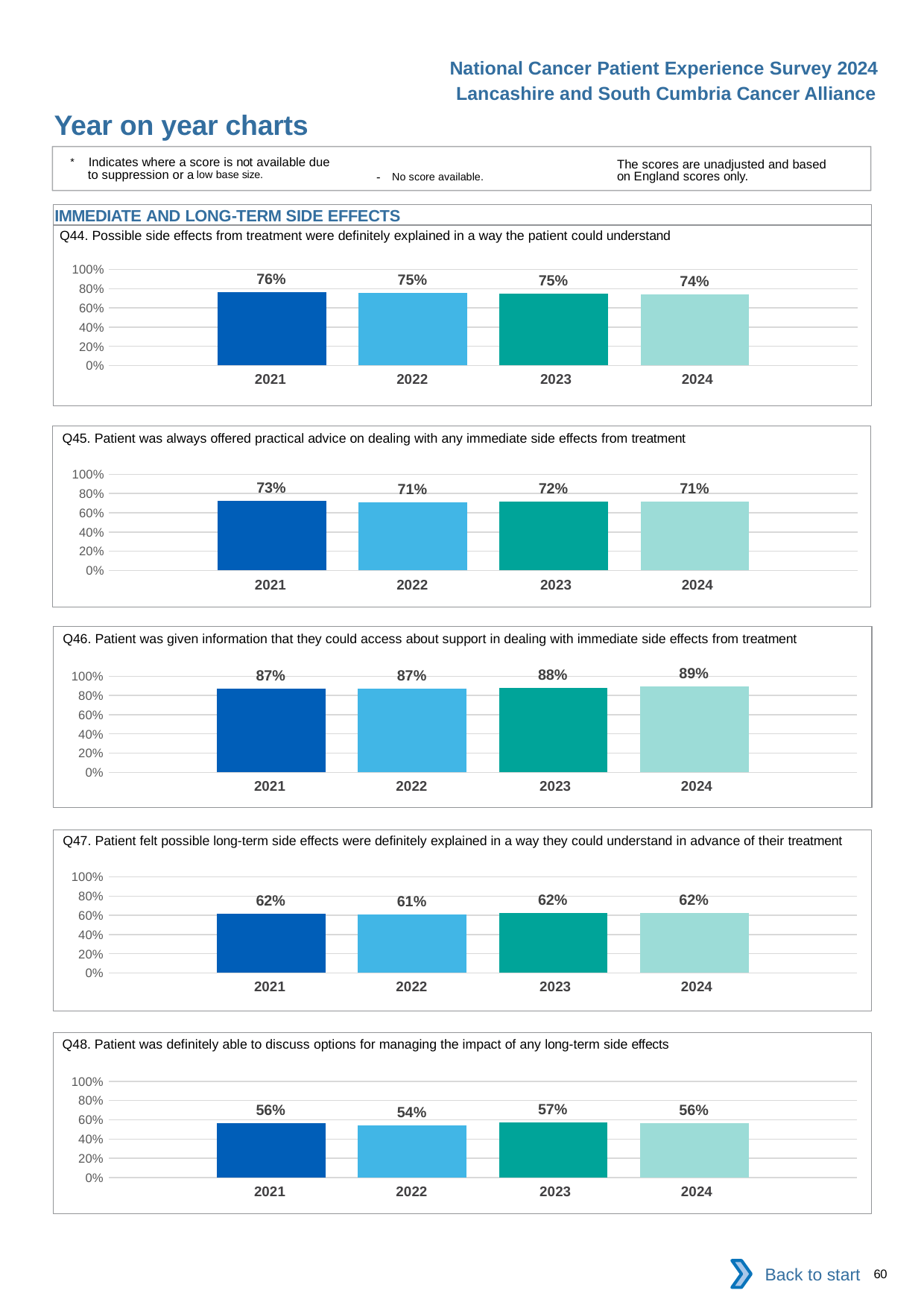
In the Q46 chart, do the values generally rise or fall from 2021 to 2024? rise In the Q48 chart, which is larger, the value for 2021 or the value for 2022? 2021 In the Q44 chart, which year has the lowest value? 2024 What kind of chart is the Q44 chart? bar chart In the Q45 chart, what is the difference between the 2021 and 2022 values? 2% In the Q47 chart, what is the value for 2022? 61% In the Q48 chart, which year has the highest value? 2023 In the Q45 chart, which year has the highest value? 2021 How many years are shown in the Q48 chart? 4 In the Q46 chart, what is the value for 2024? 89% In the Q44 chart, what is the value for 2021? 76% In the Q47 chart, is the value for 2023 greater or less than 80%? less